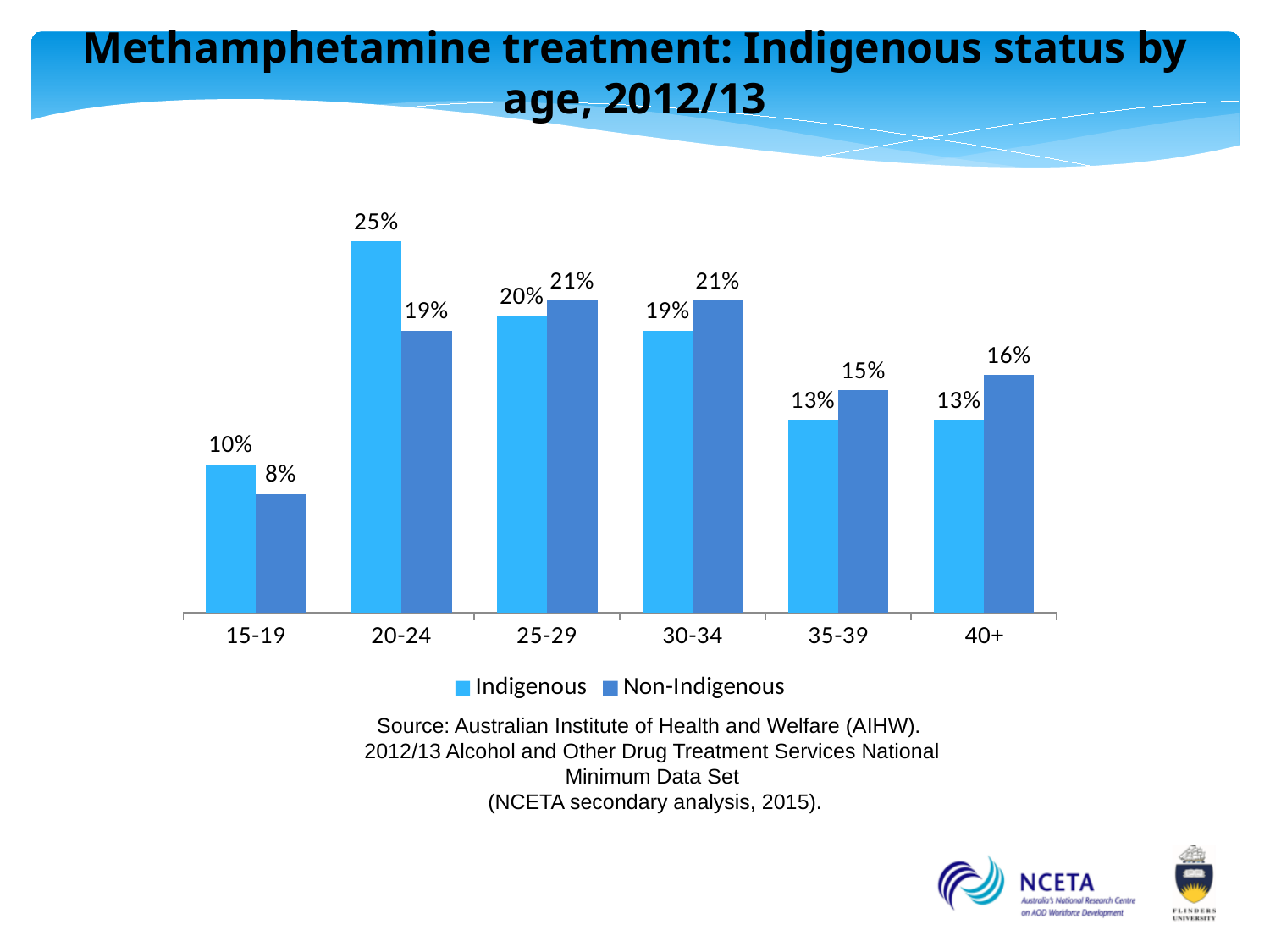
What is the Non-Indigenous value for the 15-19 age group? 8% How many series does the legend list? 2 What is the title of the chart? Methamphetamine treatment: Indigenous status by age, 2012/13 What is the Indigenous value for the 20-24 age group? 25% What is the difference between the Indigenous and Non-Indigenous values for the 20-24 age group? 6% Which is larger for the 35-39 age group, the Indigenous or the Non-Indigenous value? Non-Indigenous Which age group has the highest Indigenous value? 20-24 What is the Non-Indigenous value for the 40+ age group? 16% What kind of chart is shown on the slide? Bar chart Which age group has the lowest Non-Indigenous value? 15-19 Do the Non-Indigenous values rise or fall from the 30-34 age group to the 35-39 age group? Fall How many age groups are shown on the x axis? 6